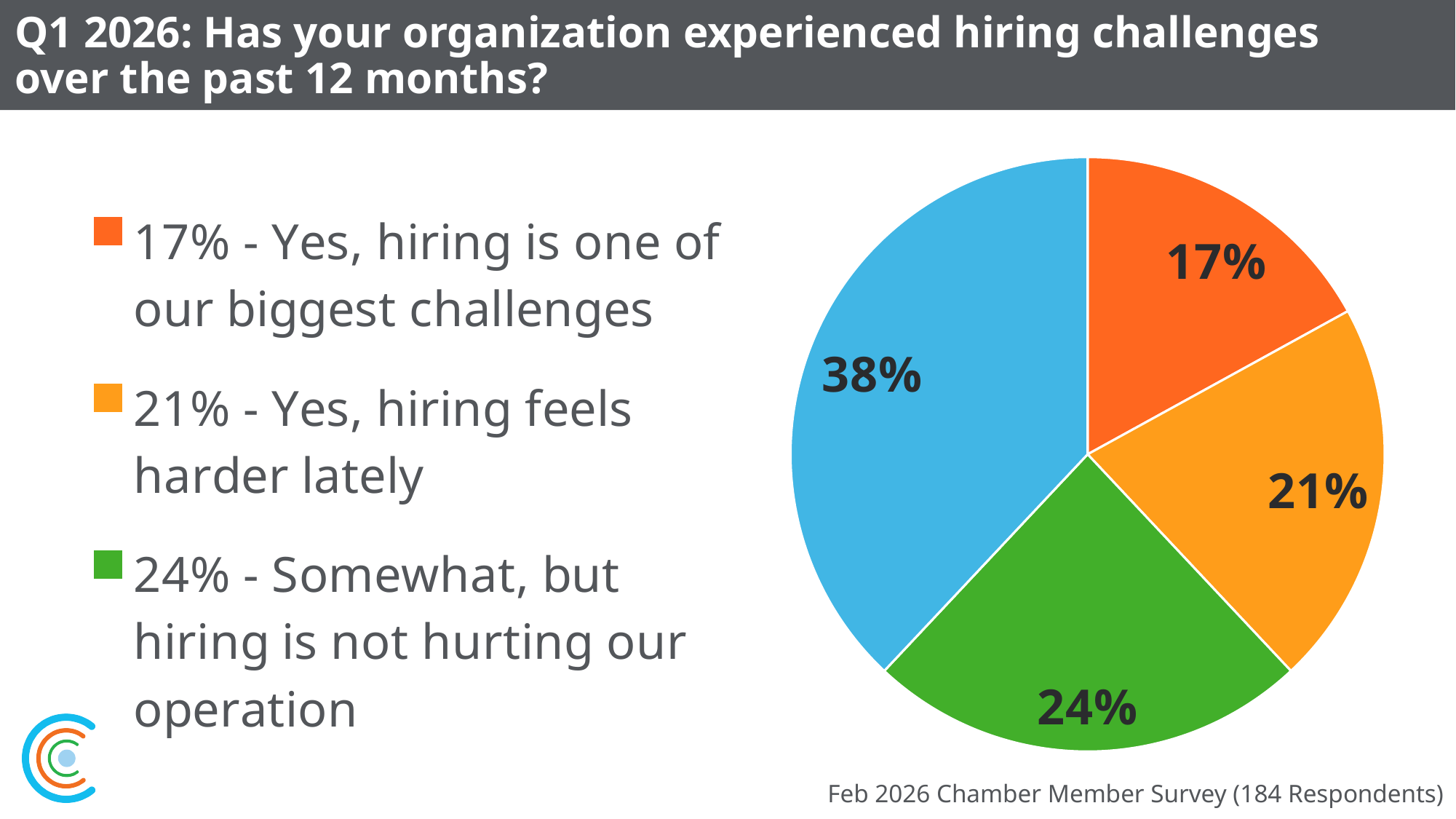
What share of respondents said "Yes, hiring feels harder lately"? 21% Which response has the smallest slice of the pie? Yes, hiring is one of our biggest challenges What share of respondents said "Yes, hiring is one of our biggest challenges"? 17% How many slices does the pie chart have? 4 Which is larger: the share for "Yes, hiring feels harder lately" or the share for "Somewhat, but hiring is not hurting our operation"? Somewhat, but hiring is not hurting our operation How many respondents does the source note say took part in the survey? 184 What is the combined share of the two "Yes" responses ("hiring is one of our biggest challenges" and "hiring feels harder lately")? 38% What kind of chart is shown on the slide? pie chart What is the difference in percentage points between the "Somewhat, but hiring is not hurting our operation" slice and the "Yes, hiring is one of our biggest challenges" slice? 7 What colour is the slice for "Somewhat, but hiring is not hurting our operation"? green What is the percentage shown on the largest slice of the pie? 38% What share of respondents said "Somewhat, but hiring is not hurting our operation"? 24%